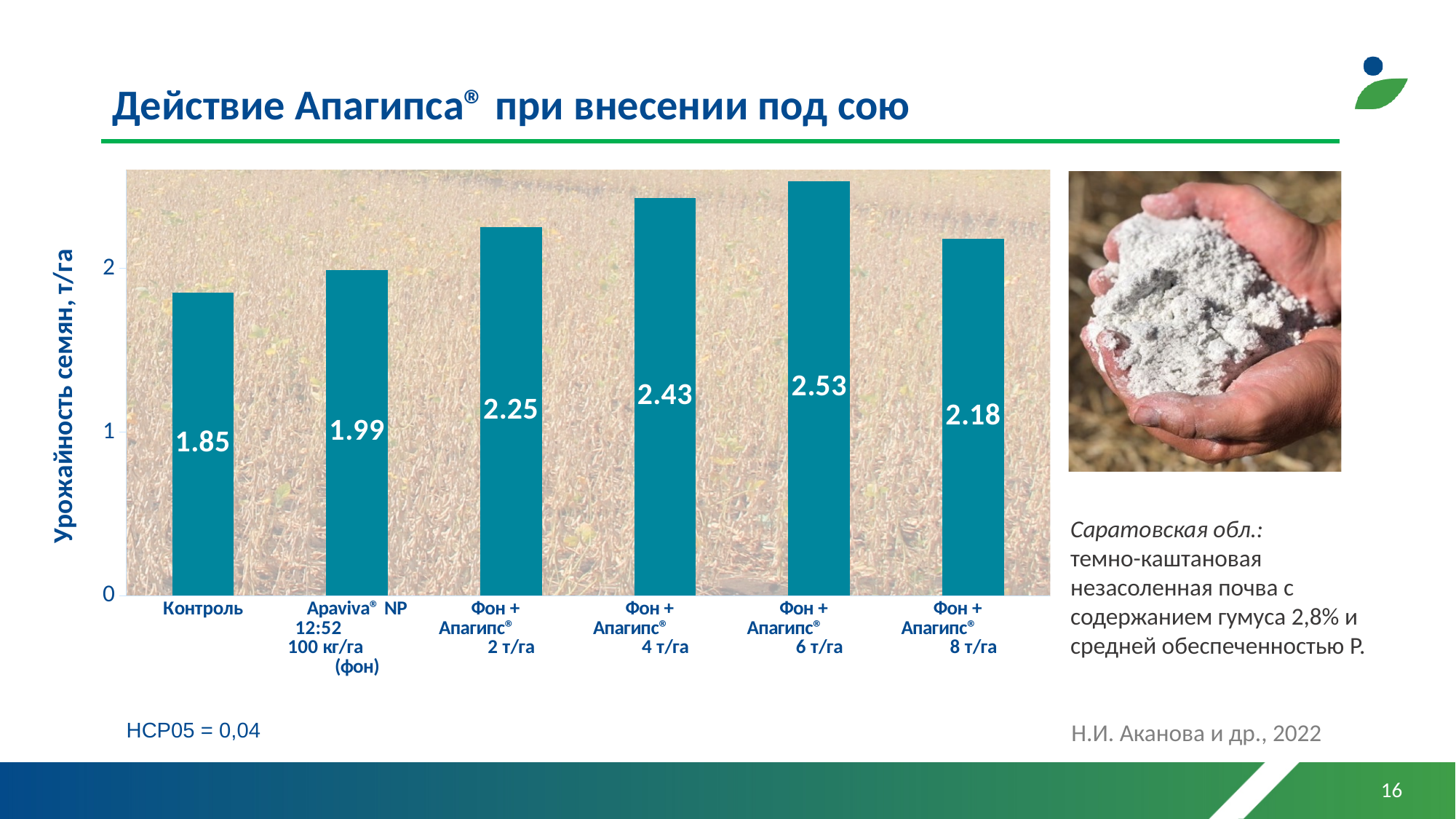
What is the seed yield for the Контроль (control) bar? 1.85 What is the difference in seed yield between Фон + Апагипс 6 т/га and Контроль? 0.68 What is the seed yield for Фон + Апагипс 8 т/га? 2.18 What is the seed yield for Apaviva NP 12:52 100 кг/га (фон)? 1.99 What is the label of the vertical axis of the chart? Урожайность семян, т/га Is the seed yield for Контроль greater or less than 2? less What type of chart is shown on the slide? bar chart Which category has the lowest seed yield? Контроль What is the seed yield for Фон + Апагипс 6 т/га? 2.53 Which category has the highest seed yield? Фон + Апагипс 6 т/га Which has a higher seed yield: Фон + Апагипс 4 т/га or Фон + Апагипс 8 т/га? Фон + Апагипс 4 т/га How many bars (categories) are shown in the chart? 6